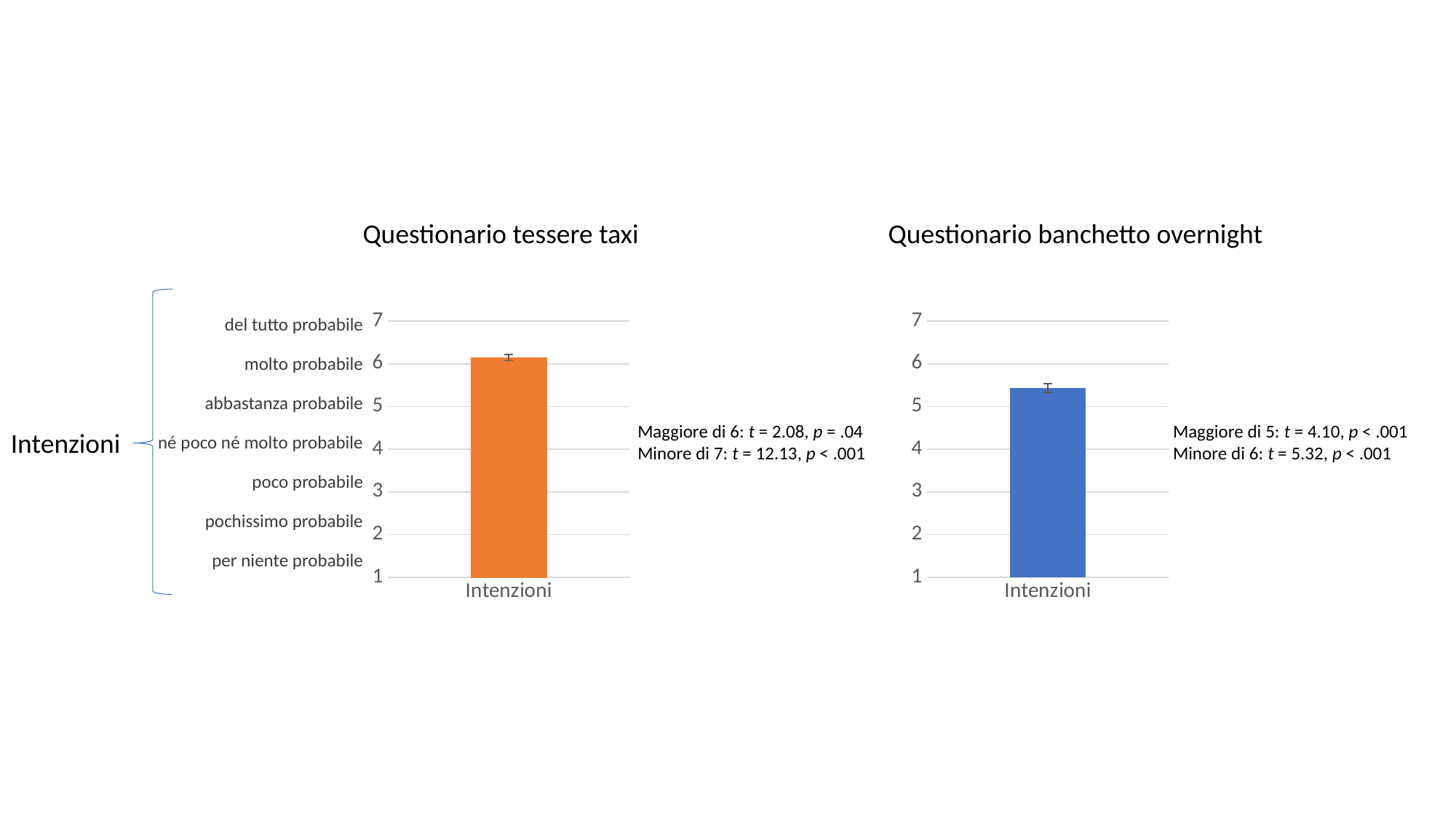
How many bars are plotted in the 'Questionario tessere taxi' chart? 1 In the 'Questionario tessere taxi' chart, is the value for Intenzioni greater or less than 6? greater What kind of chart is the 'Questionario banchetto overnight' chart? bar chart What is the title of the chart on the right side of the slide? Questionario banchetto overnight How many bars are plotted in the 'Questionario banchetto overnight' chart? 1 In the 'Questionario banchetto overnight' chart, is the value for Intenzioni greater or less than 6? less Which chart shows the higher Intenzioni bar, 'Questionario tessere taxi' or 'Questionario banchetto overnight'? Questionario tessere taxi What colour is the bar in the 'Questionario tessere taxi' chart? orange What is the category label on the x axis of the 'Questionario banchetto overnight' chart? Intenzioni In the 'Questionario tessere taxi' chart, is the value for Intenzioni greater or less than 7? less What kind of chart is the 'Questionario tessere taxi' chart? bar chart